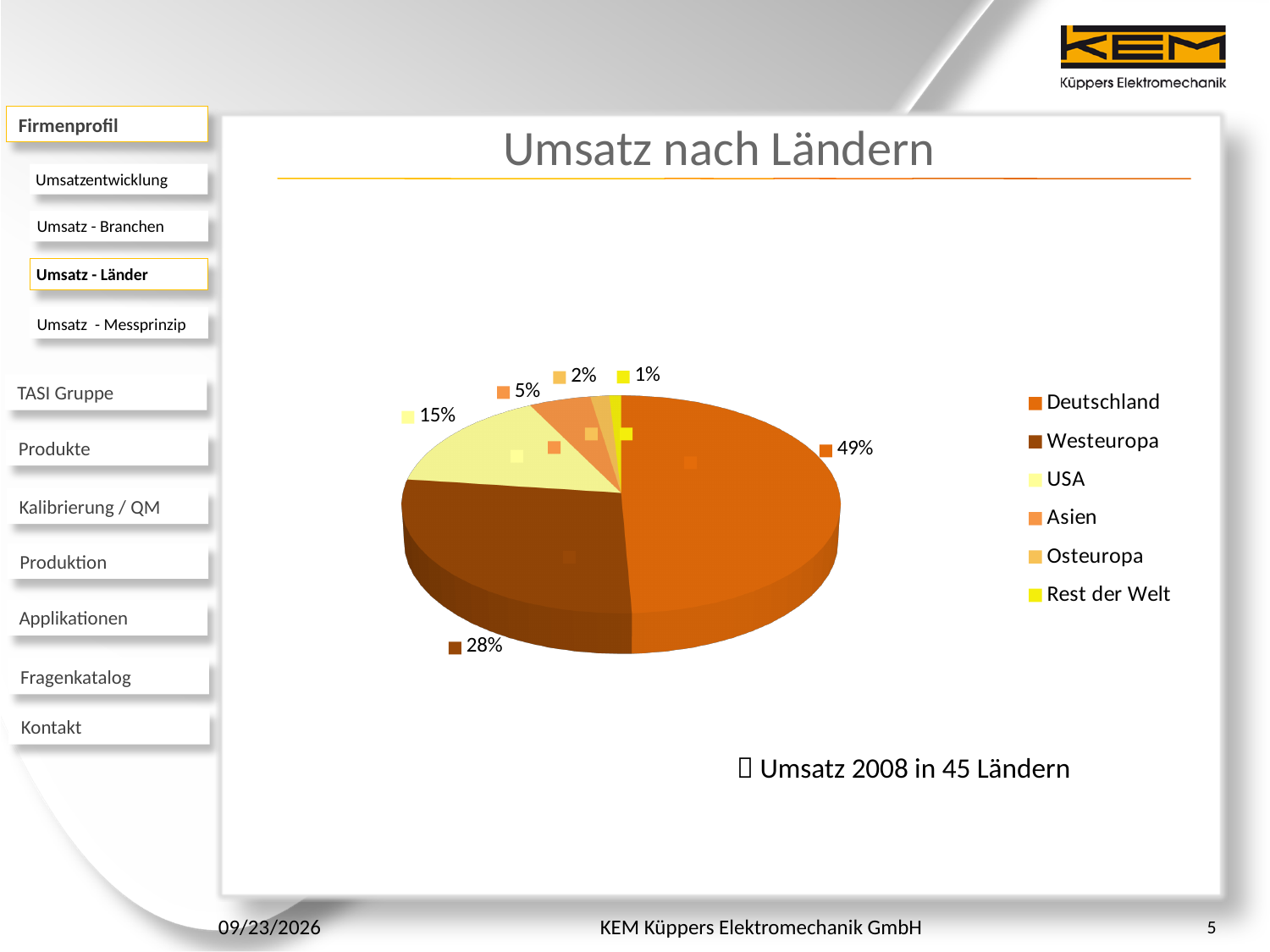
What share of the pie does Deutschland have? 49% Which is larger, the share for USA or the share for Asien? USA Which category has the largest slice of the pie? Deutschland What is the difference in percentage points between Deutschland and Westeuropa? 21 Which category has the smallest slice of the pie? Rest der Welt What share of the pie does USA have? 15% What share of the pie does Osteuropa have? 2% What is the title of the chart? Umsatz nach Ländern What kind of chart is shown on the slide? pie chart How many categories does the legend list? 6